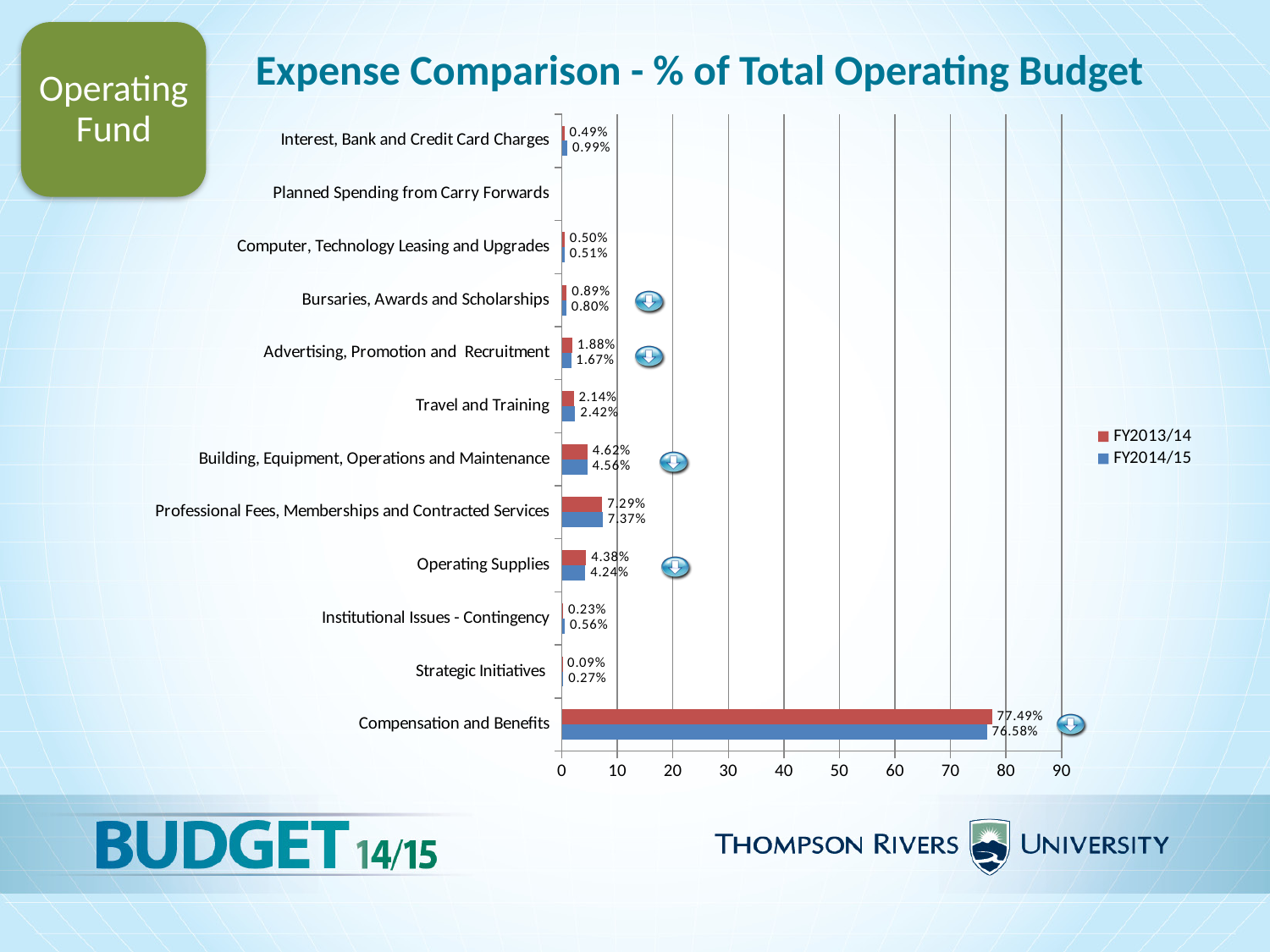
Is the FY2013/14 value for Compensation and Benefits greater or less than 70? greater What is the FY2014/15 value for Compensation and Benefits? 76.58% Which category has the lowest FY2014/15 value among those with a printed label? Strategic Initiatives What kind of chart is shown on the slide? bar chart What is the title of the chart? Expense Comparison - % of Total Operating Budget What is the FY2013/14 value for Professional Fees, Memberships and Contracted Services? 7.29% How many categories are listed on the vertical axis? 12 For Operating Supplies, which is larger: the FY2013/14 value or the FY2014/15 value? FY2013/14 How many series does the legend list? 2 What is the FY2014/15 value for Travel and Training? 2.42% Which category has the highest FY2013/14 value? Compensation and Benefits What is the difference between the FY2013/14 and FY2014/15 values for Compensation and Benefits? 0.91%